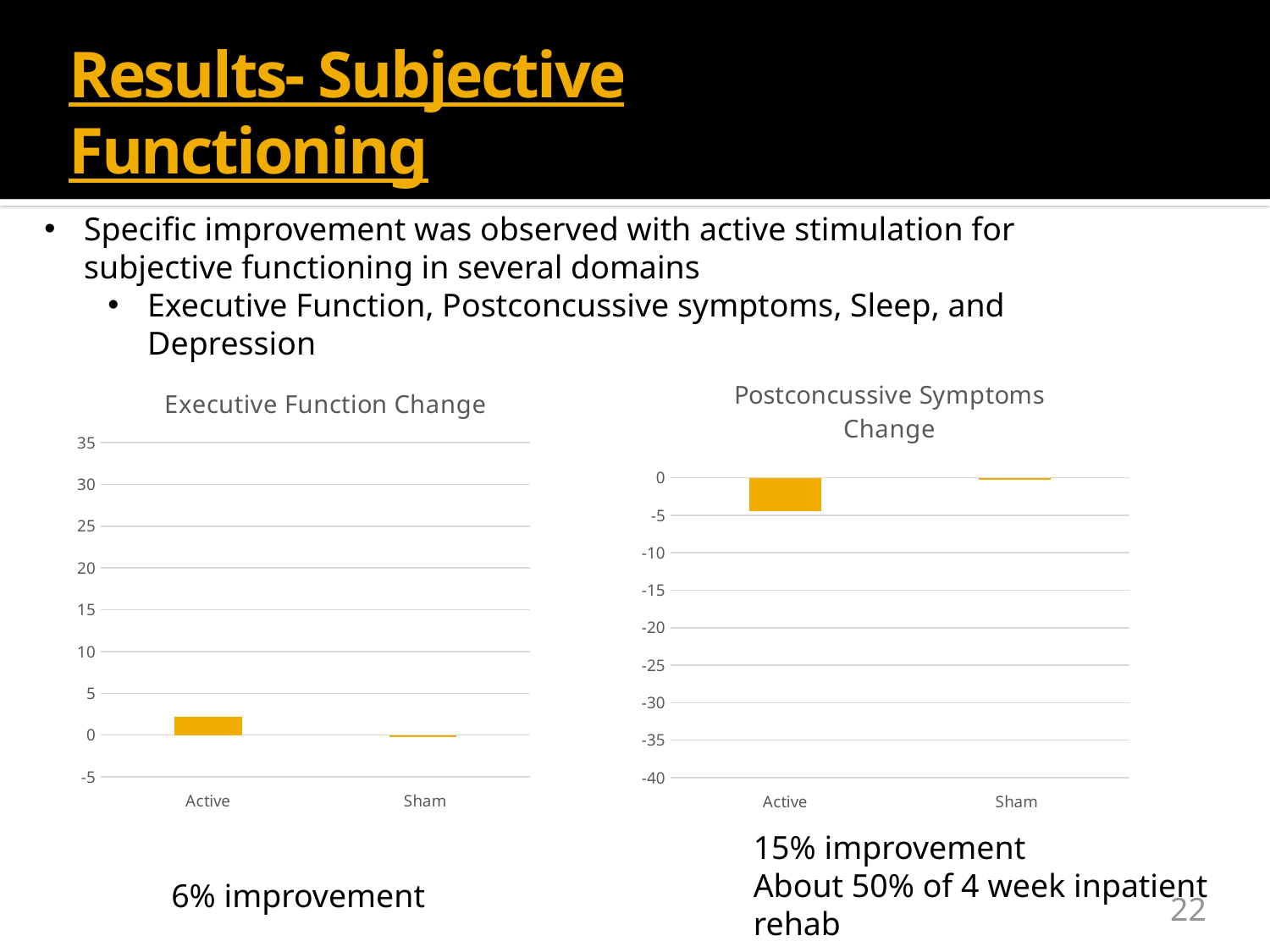
What is the title of the chart on the right side of the slide? Postconcussive Symptoms Change In the Postconcussive Symptoms Change chart, is the value for Active greater or less than -10? greater In the Postconcussive Symptoms Change chart, which category has the lowest value? Active In the Executive Function Change chart, which category has the higher value, Active or Sham? Active How many categories are shown on the x axis of the Executive Function Change chart? 2 What kind of chart is the Executive Function Change chart? bar chart In the Executive Function Change chart, is the value for Active greater or less than 0? greater What kind of chart is the Postconcussive Symptoms Change chart? bar chart In the Executive Function Change chart, is the value for Active greater or less than 5? less How many categories are shown on the x axis of the Postconcussive Symptoms Change chart? 2 In the Executive Function Change chart, which category has the highest value? Active